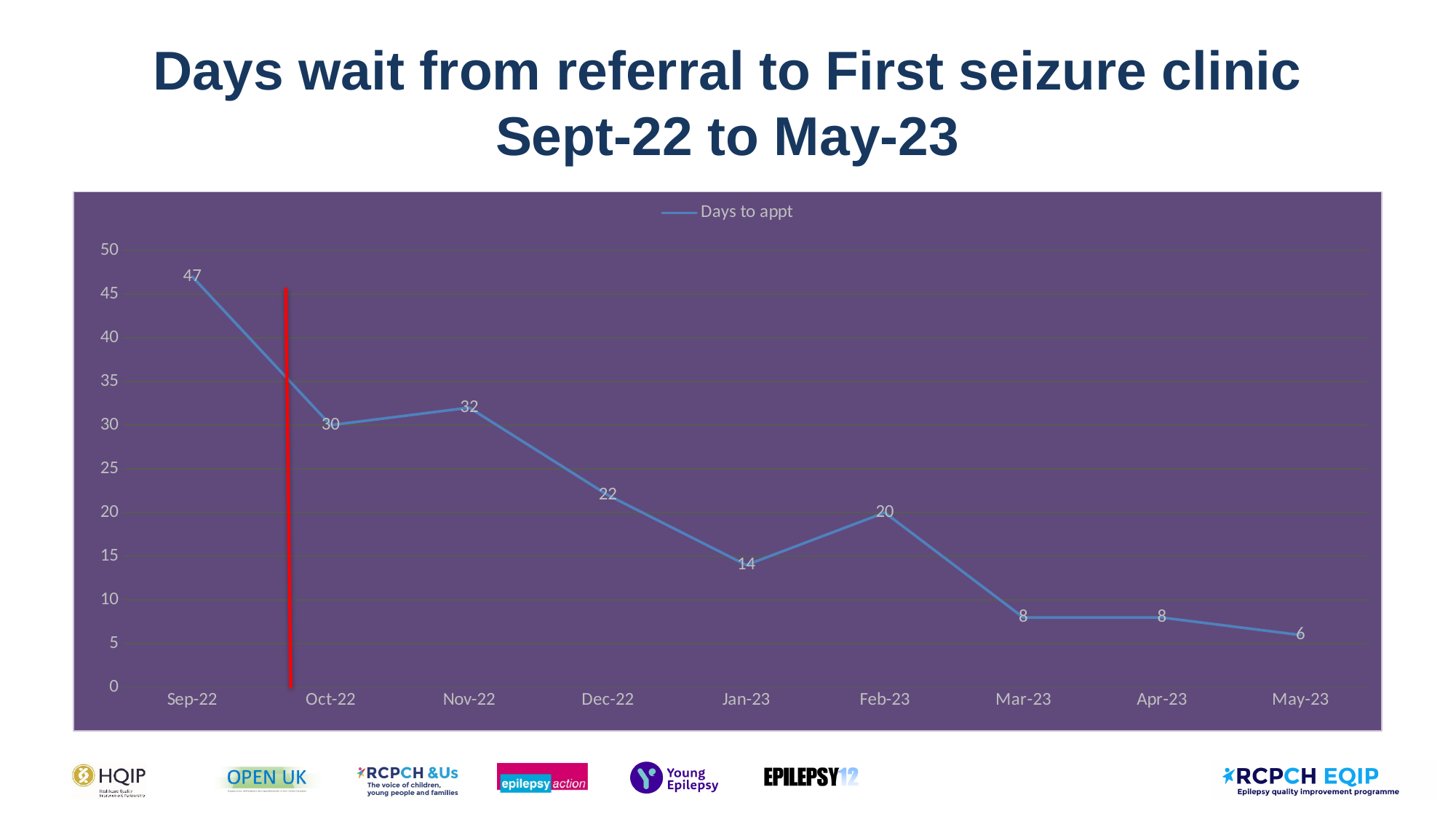
What is the value for Dec-22? 22 Which is larger, the value for Oct-22 or the value for Nov-22? Nov-22 Is the value for Jan-23 greater or less than 15? less What kind of chart is shown? line chart How many series does the legend list? 1 Which month has the lowest days to appointment? May-23 What is the value for Sep-22? 47 What is the value for May-23? 6 What is the difference between the values for Sep-22 and May-23? 41 Do the values generally rise or fall from Sep-22 to May-23? fall How many months are plotted on the x axis? 9 Which month has the highest days to appointment? Sep-22